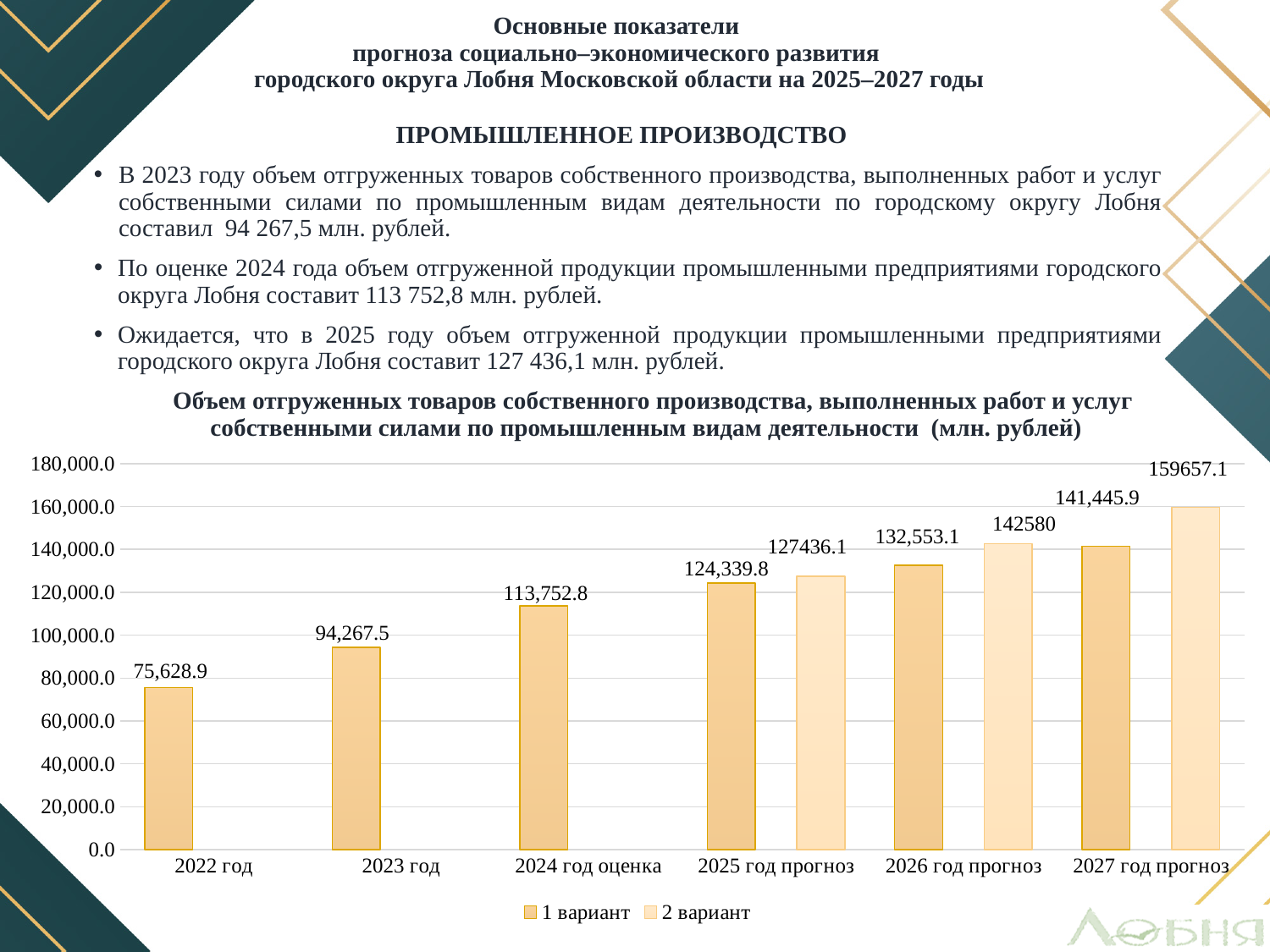
Which is larger for 2025 год прогноз: 1 вариант or 2 вариант? 2 вариант How many series does the legend list? 2 Do the values of 1 вариант rise or fall from 2022 год to 2027 год прогноз? Rise What is the value for 2022 год? 75,628.9 What is the difference between 2 вариант and 1 вариант for 2027 год прогноз? 18,211.2 What is the value for 2023 год? 94,267.5 Which bar has the highest value on the chart? 2 вариант for 2027 год прогноз What kind of chart is shown? Bar chart What is the value for 2024 год оценка? 113,752.8 What is the value of 2 вариант for 2027 год прогноз? 159657.1 Which category has the lowest value? 2022 год What is the value of 1 вариант for 2026 год прогноз? 132,553.1